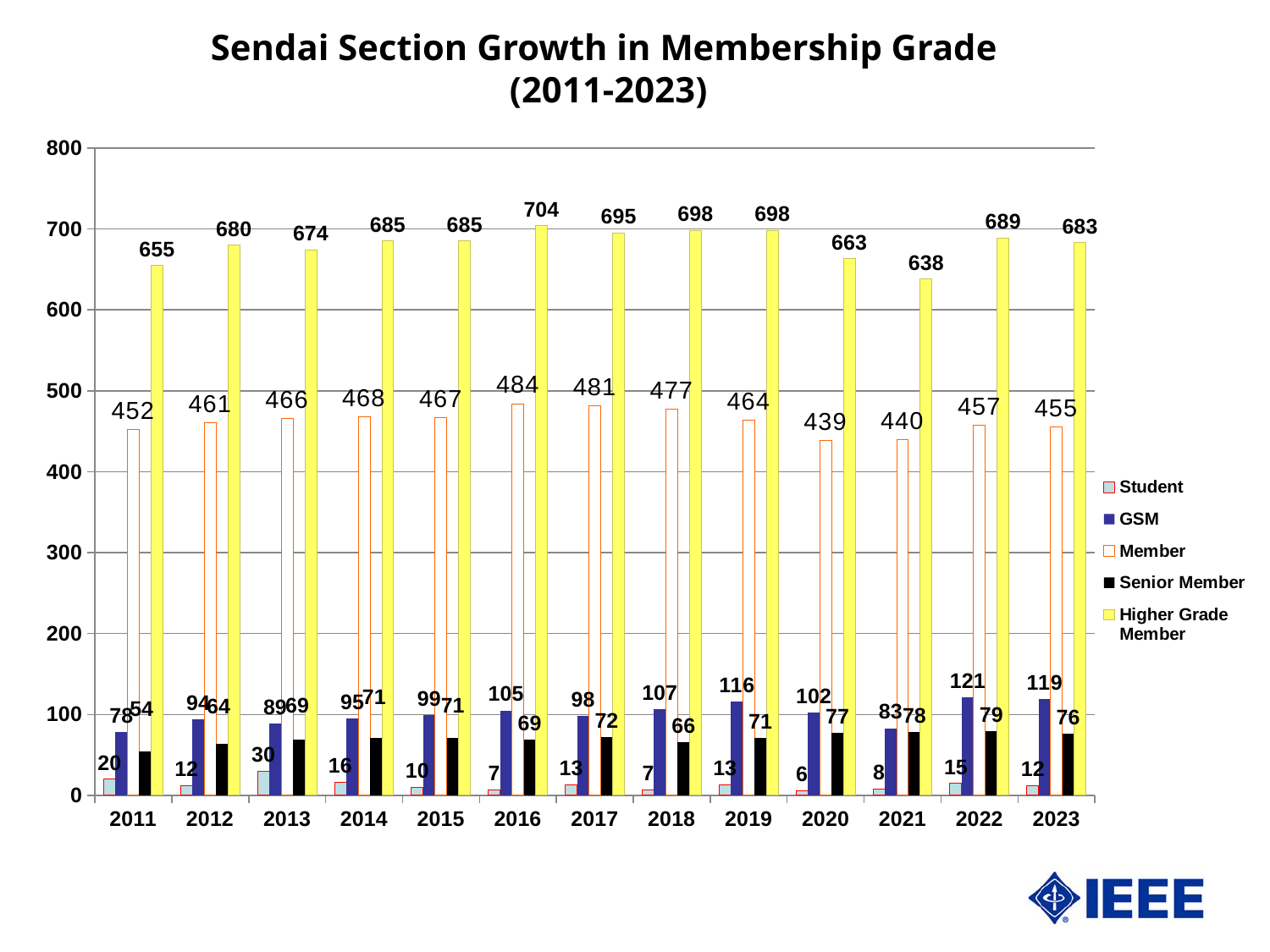
What is the value for Higher Grade Member in 2016? 704 What kind of chart is shown on the slide? bar chart In which year is the GSM value highest? 2022 In which year is the Higher Grade Member value highest? 2016 In which year is the Higher Grade Member value lowest? 2021 In which year is the Member value highest? 2016 What is the value for Member in 2020? 439 How many years are shown on the x axis? 13 What is the value for Student in 2013? 30 Which year has the larger GSM value, 2022 or 2023? 2022 How many series does the legend list? 5 What is the difference between the Higher Grade Member values in 2016 and 2021? 66